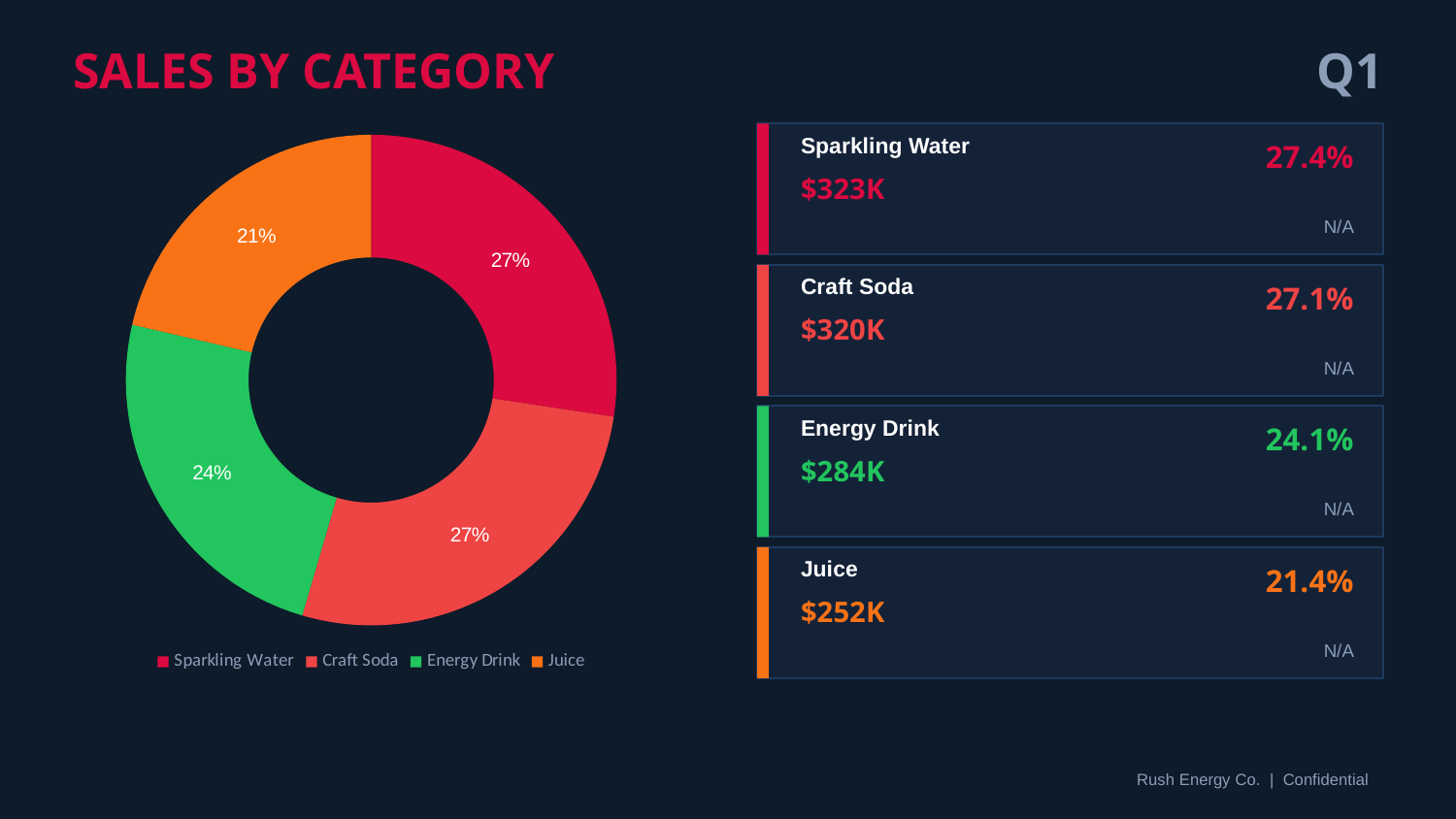
What percentage of the pie chart does Craft Soda account for? 27% Which slice is larger in the pie chart, Energy Drink or Juice? Energy Drink What percentage of the pie chart does Energy Drink account for? 24% Which category has the smallest slice in the pie chart? Juice By how many percentage points does the Energy Drink slice exceed the Juice slice? 3 percentage points What percentage of the pie chart does Juice account for? 21% What percentage of the pie chart does Sparkling Water account for? 27% How many categories are shown in the pie chart? 4 What is the title of the chart on the slide? SALES BY CATEGORY What kind of chart is shown on the slide? Pie chart (donut) How many entries does the chart legend list? 4 Which slice is larger in the pie chart, Sparkling Water or Energy Drink? Sparkling Water